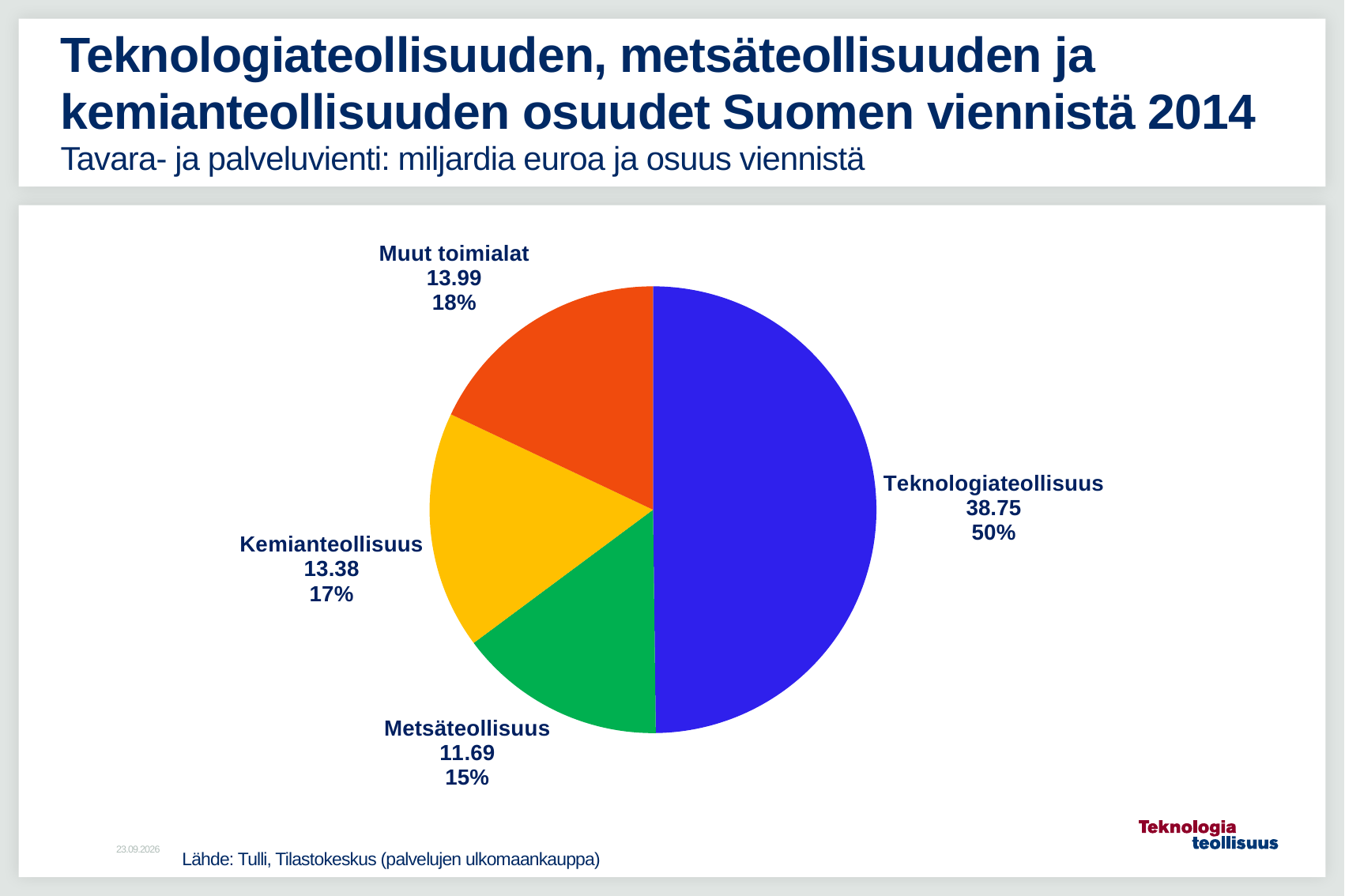
What type of chart is shown on the slide? Pie chart Which has a larger value, Kemianteollisuus or Metsäteollisuus? Kemianteollisuus What colour is the Teknologiateollisuus slice? Blue What is the difference between the values for Muut toimialat and Kemianteollisuus? 0.61 What is the difference between the values for Teknologiateollisuus and Metsäteollisuus? 27.06 What share of the pie does Muut toimialat have? 18% How many slices does the pie chart have? 4 Which slice of the pie is the smallest? Metsäteollisuus What is the value shown for Teknologiateollisuus? 38.75 Which slice of the pie is the largest? Teknologiateollisuus What is the value shown for Kemianteollisuus? 13.38 What share of the pie does Metsäteollisuus have? 15%